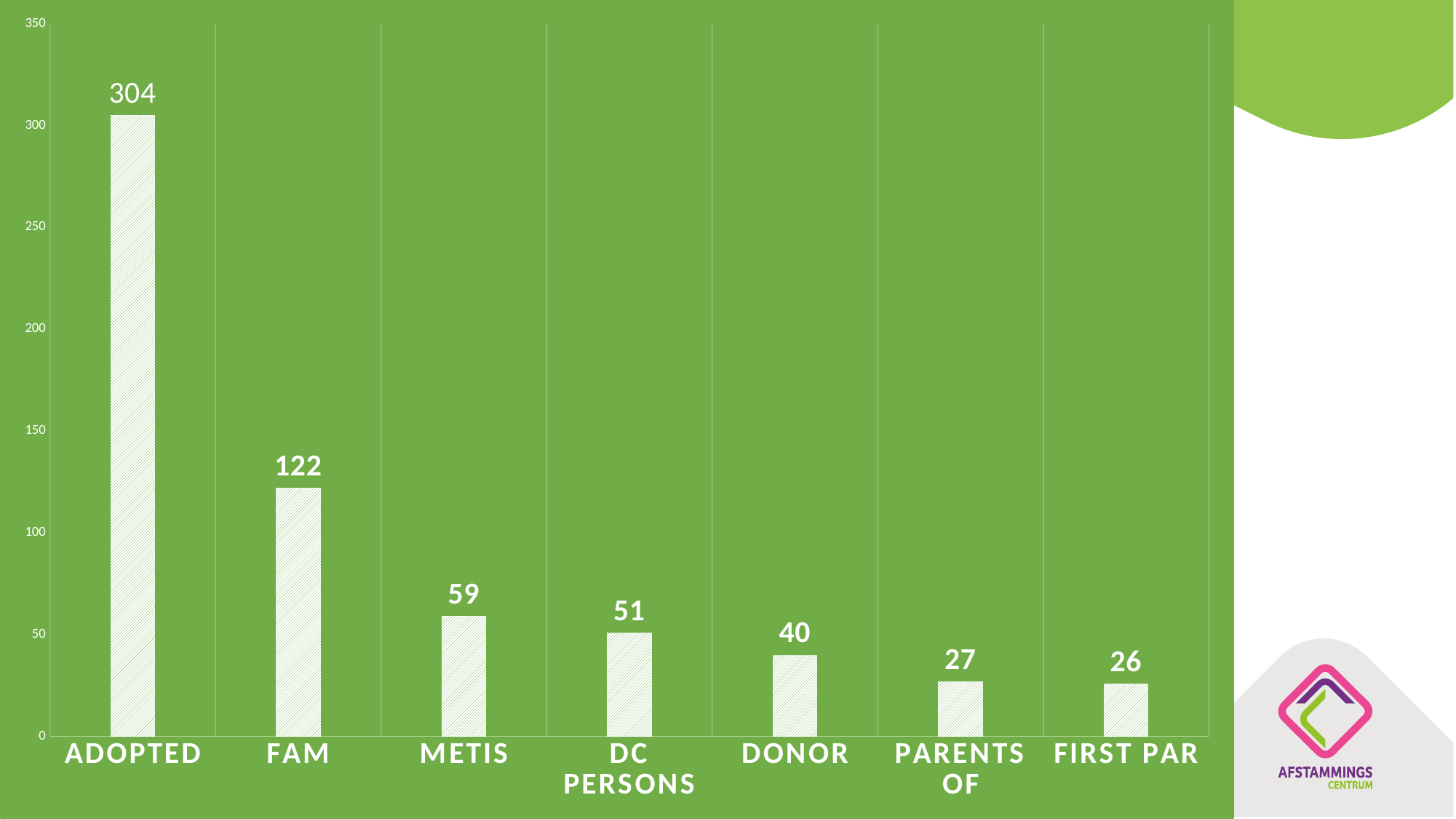
How many categories are shown on the x axis? 7 What is the value for DONOR? 40 Which is larger, the value for METIS or the value for DONOR? METIS What is the difference between the values for ADOPTED and FAM? 182 Which category has the lowest value? FIRST PAR What kind of chart is shown on the slide? bar chart Which category has the highest value? ADOPTED What is the difference between the values for METIS and DC PERSONS? 8 What is the value for ADOPTED? 304 Do the values rise or fall from left to right along the x axis? fall What is the value for FAM? 122 What is the value for DC PERSONS? 51